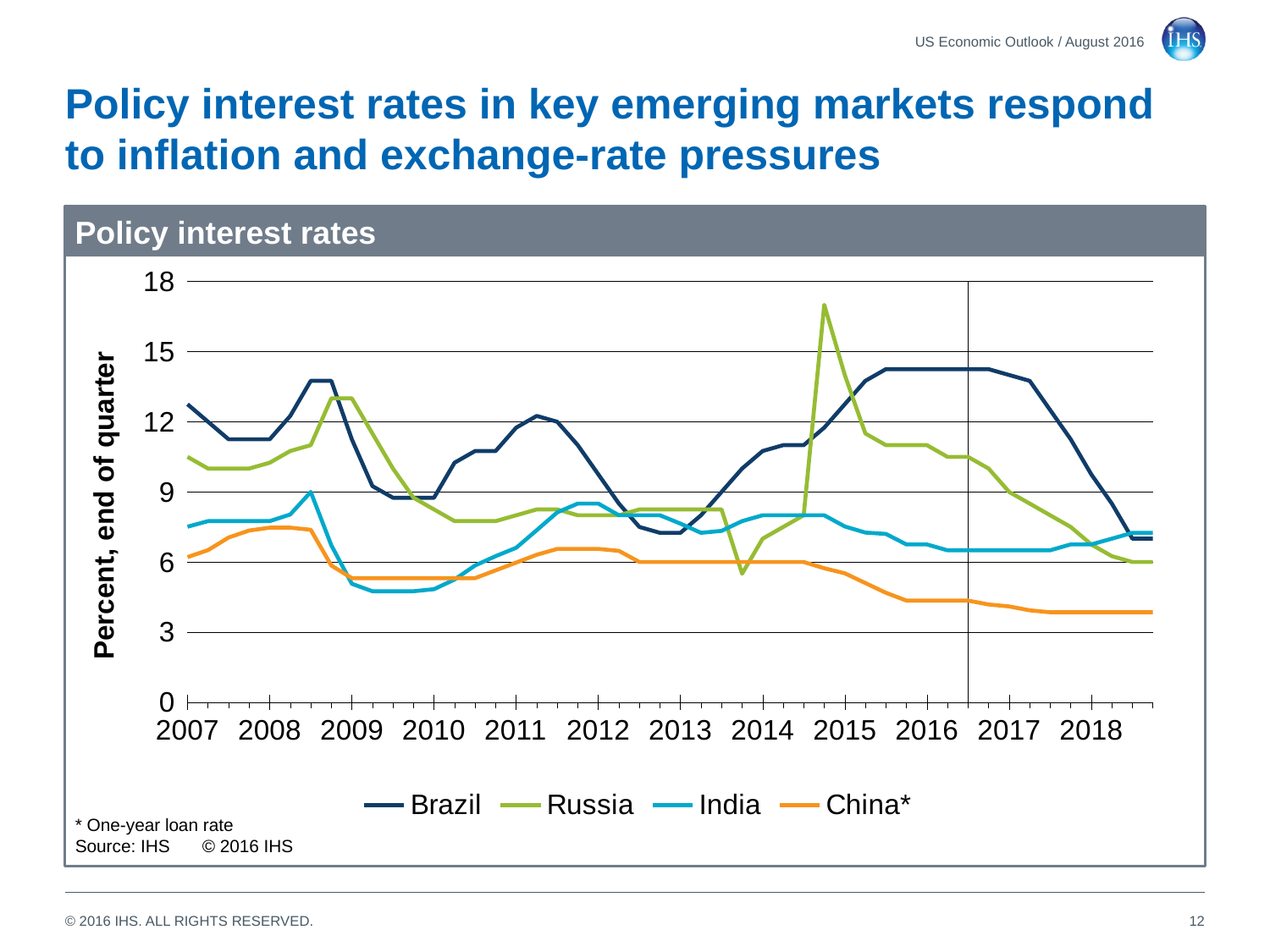
What kind of chart is shown on the slide? Line chart At the start of 2007, which is higher, Brazil or China*? Brazil Does the China* line rise or fall from 2015 to 2018? fall According to the footnote, what does the asterisk next to China indicate? One-year loan rate Is the value for China* at the end of 2018 greater or less than 6? less How many series does the legend list? 4 Which series reaches the highest value anywhere on the chart? Russia Which series has the lowest value at the end of 2018? China* What is the title of the chart? Policy interest rates How many year labels are shown on the x axis? 12 Is the value for Brazil at the start of 2016 greater or less than 12? greater Is the peak value for Russia greater or less than 15? greater